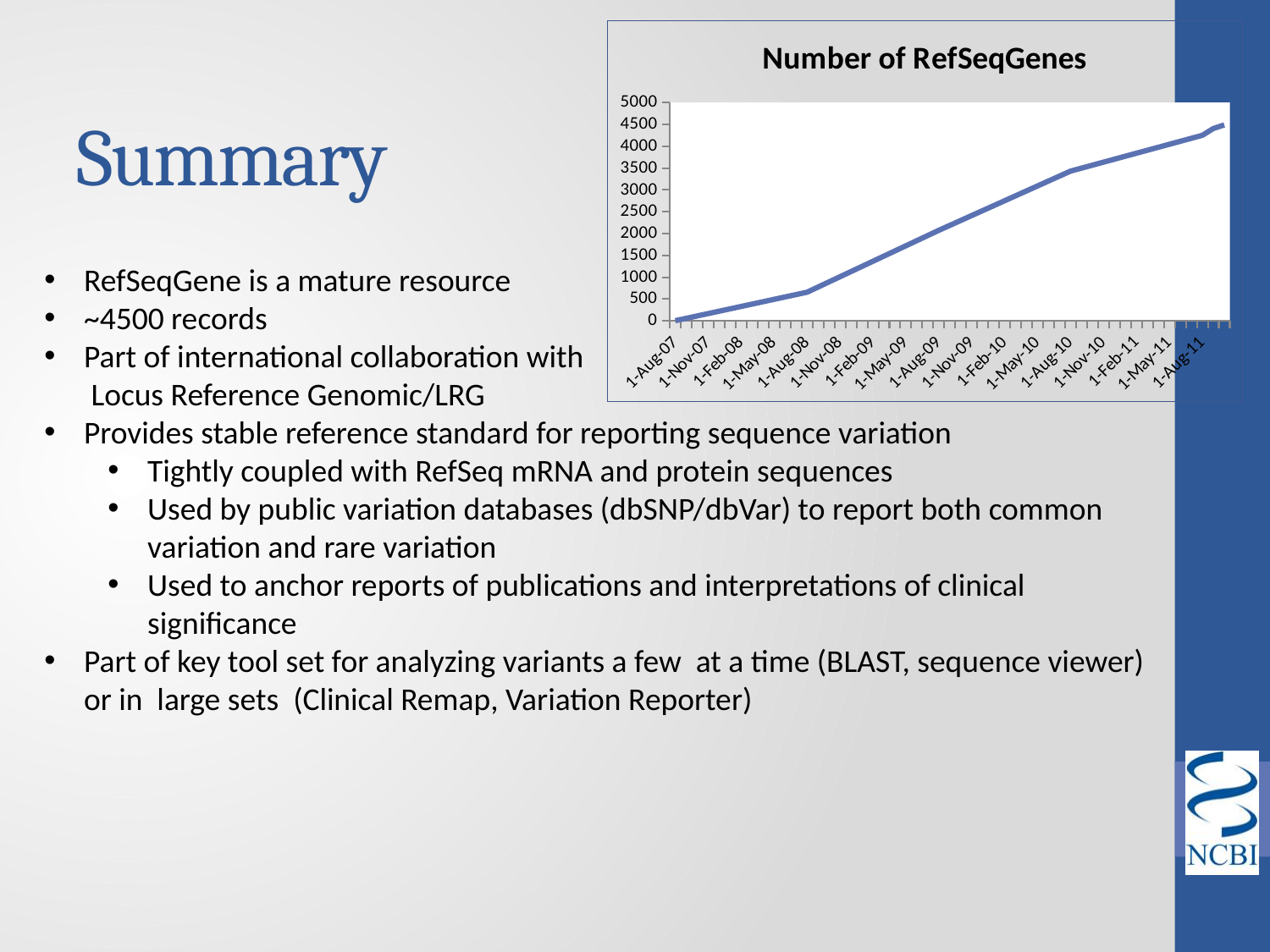
Is the value for 1-Aug-10 greater or less than 3000? greater Is the value for 1-Aug-11 greater or less than 4000? greater What is the title of the chart? Number of RefSeqGenes How many date labels are shown along the x axis of the chart? 17 Is the value for 1-Aug-07 greater or less than 500? less Which is larger, the value for 1-Nov-08 or the value for 1-Nov-10? 1-Nov-10 Which labeled date on the x axis has the lowest number of RefSeqGenes? 1-Aug-07 What kind of chart is shown on the slide? line chart Which labeled date on the x axis has the highest number of RefSeqGenes? 1-Aug-11 Do the values in the chart rise or fall from left to right along the x axis? rise